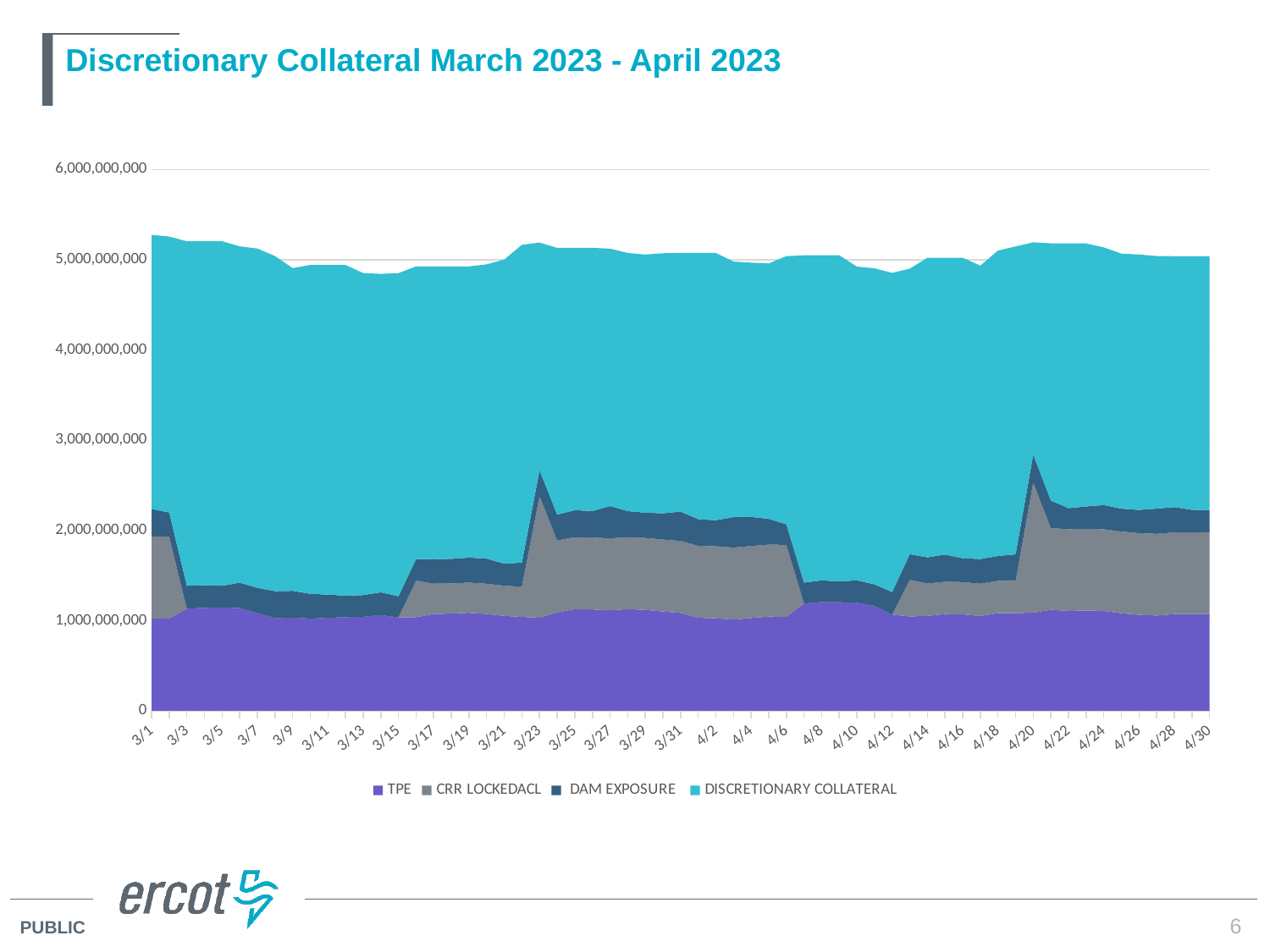
Is the cumulative top of the DAM EXPOSURE band on 4/8 greater or less than 2,000,000,000? less What is the title of the chart? Discretionary Collateral March 2023 - April 2023 Does the total stacked value rise or fall from 3/1 to 3/9? fall Is the total stacked value on 4/30 greater or less than 6,000,000,000? less Which series occupies the largest area of the chart? DISCRETIONARY COLLATERAL Is the TPE value on 3/1 greater or less than 2,000,000,000? less What kind of chart is shown on the slide? Stacked area chart How many series does the legend list? 4 On 3/1, which is larger: the DISCRETIONARY COLLATERAL band or the TPE band? DISCRETIONARY COLLATERAL Which series is plotted at the bottom of the stack? TPE